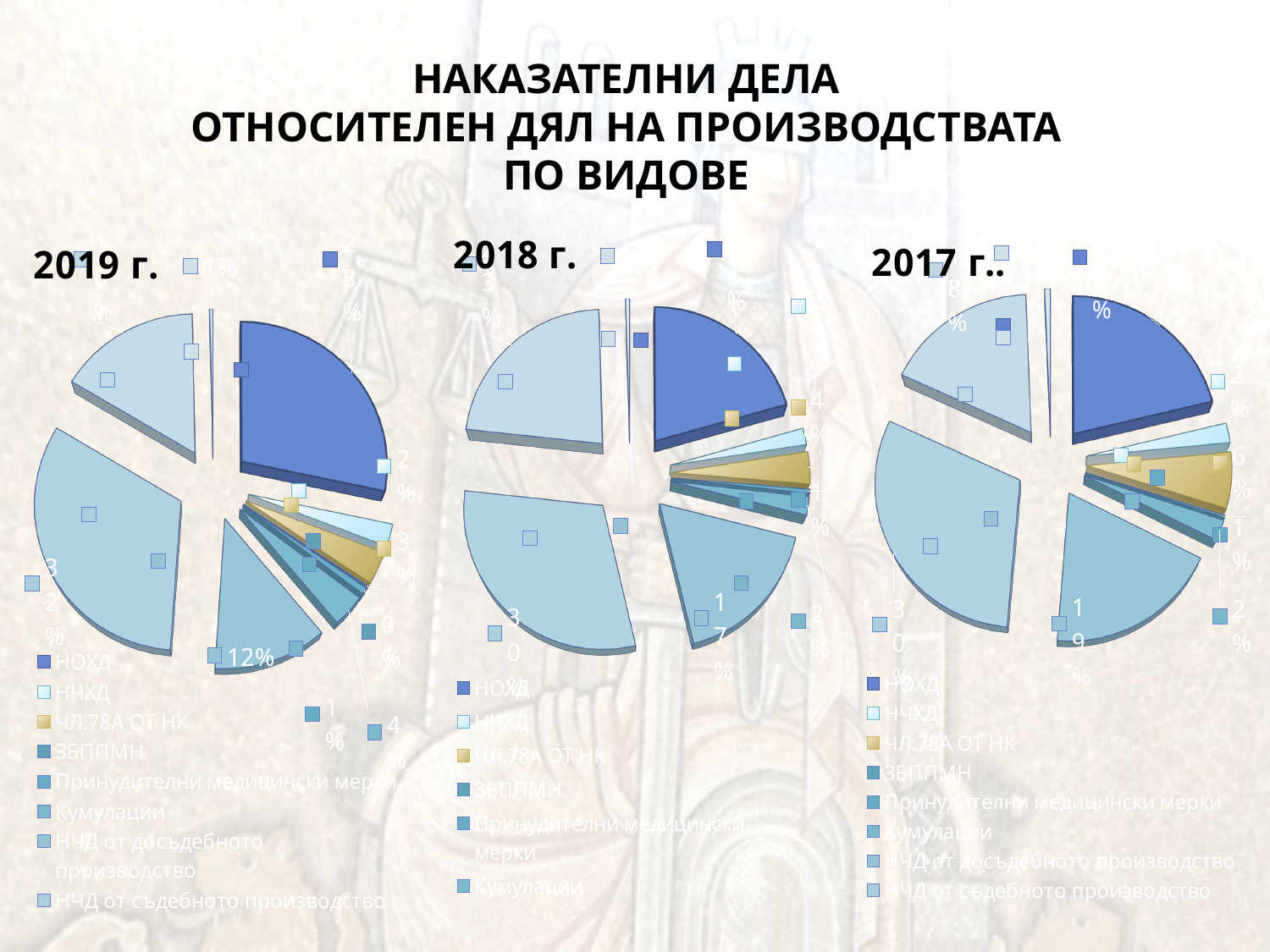
In the 2018 pie chart, which is larger: the НОХД slice or the ЧЛ.78А ОТ НК slice? НОХД How many entries does the legend of the 2018 pie chart list? 6 In the 2019 pie chart, is the НОХД slice greater or less than 50% of the pie? less How many entries does the legend of the 2019 pie chart list? 8 How many pie charts are on the slide? 3 In the 2019 pie chart, which is larger: the НОХД slice or the ЧЛ.78А ОТ НК slice? НОХД In the 2017 pie chart, which is larger: the НОХД slice or the ЧЛ.78А ОТ НК slice? НОХД How many entries does the legend of the 2017 pie chart list? 8 What is the first legend entry of the 2019 pie chart? НОХД What kind of charts are shown on the slide? Pie charts Which years do the three pie charts cover? 2019, 2018 and 2017